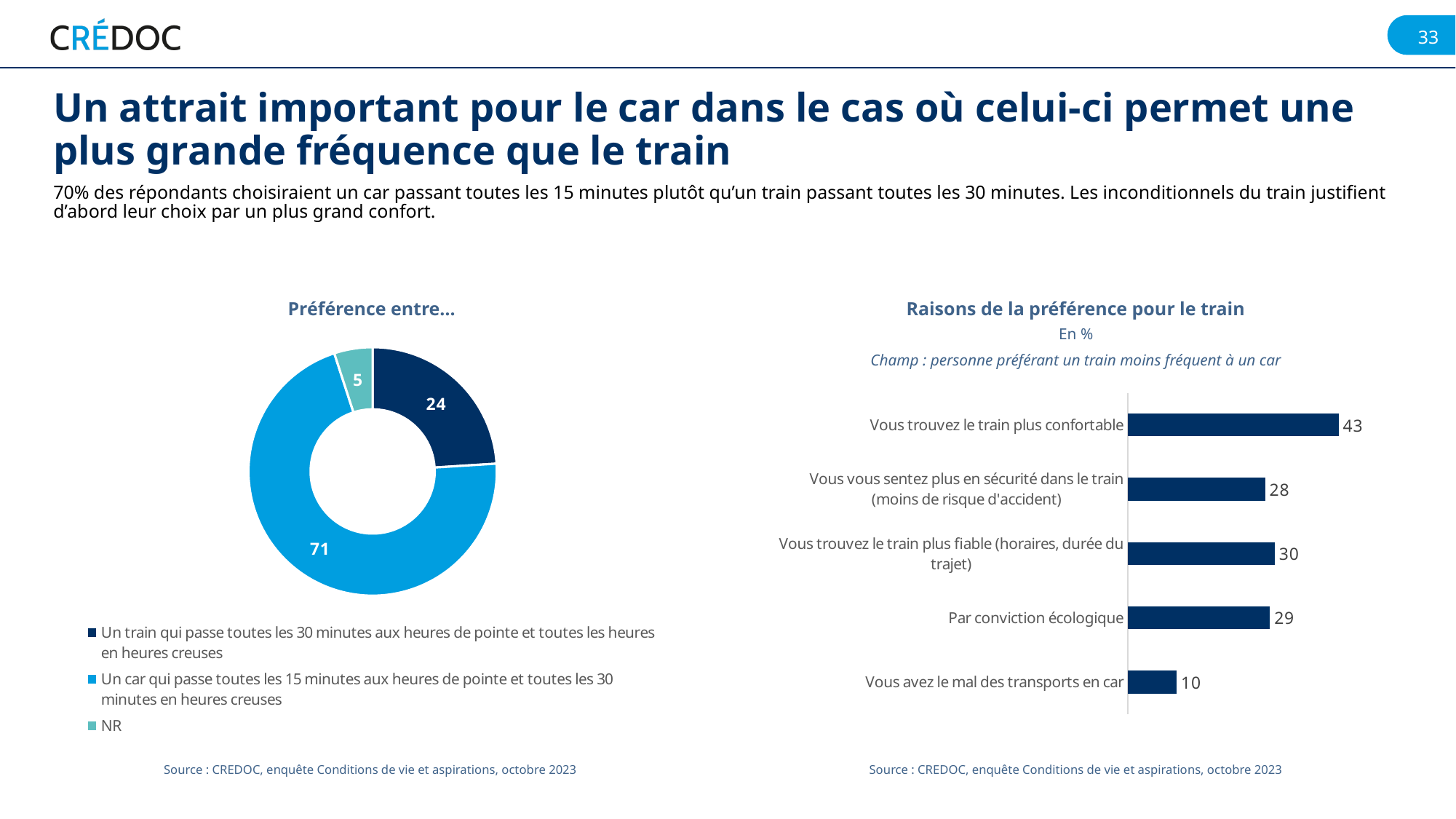
What kind of chart is 'Préférence entre…'? Doughnut chart In the 'Raisons de la préférence pour le train' chart, what is the difference between 'Vous trouvez le train plus confortable' and 'Vous avez le mal des transports en car'? 33 What kind of chart is 'Raisons de la préférence pour le train'? Bar chart In the 'Raisons de la préférence pour le train' chart, which reason has the lowest value? Vous avez le mal des transports en car In the 'Raisons de la préférence pour le train' chart, how many reasons are plotted? 5 In the 'Préférence entre…' chart, what value is shown for 'Un car qui passe toutes les 15 minutes aux heures de pointe et toutes les 30 minutes en heures creuses'? 71 In the 'Préférence entre…' chart, which category has the largest share? Un car qui passe toutes les 15 minutes aux heures de pointe et toutes les 30 minutes en heures creuses In the 'Préférence entre…' chart, what is the difference between the value for the car option and the value for the train option? 47 In the 'Raisons de la préférence pour le train' chart, what is the value for 'Vous trouvez le train plus confortable'? 43 In the 'Préférence entre…' chart, how many entries does the legend list? 3 In the 'Préférence entre…' chart, what value is shown for 'NR'? 5 In the 'Raisons de la préférence pour le train' chart, what is the value for 'Par conviction écologique'? 29